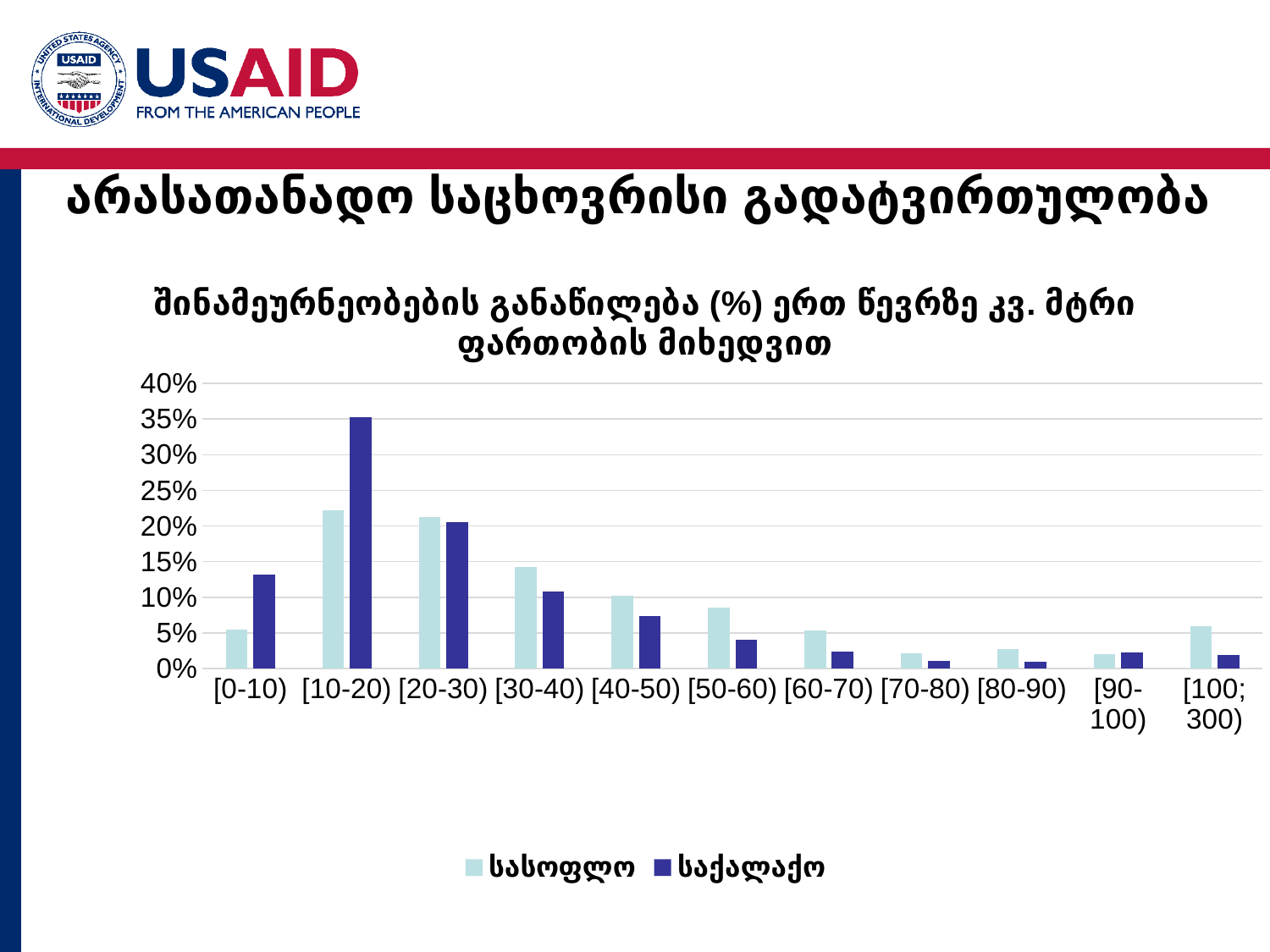
For which category is the საქალაქო value highest? [10-20) Is the სასოფლო value for [10-20) greater or less than 20%? greater What kind of chart is shown on the slide? bar chart How many series does the legend list? 2 What are the two series named in the legend? სასოფლო and საქალაქო Is the საქალაქო value for [0-10) greater or less than 10%? greater In the [30-40) category, which series has the larger value, სასოფლო or საქალაქო? სასოფლო In the [0-10) category, which series has the larger value, სასოფლო or საქალაქო? საქალაქო Is the საქალაქო value for [50-60) greater or less than 5%? less For which category is the სასოფლო value highest? [10-20) How many categories (area ranges) are shown on the x axis? 11